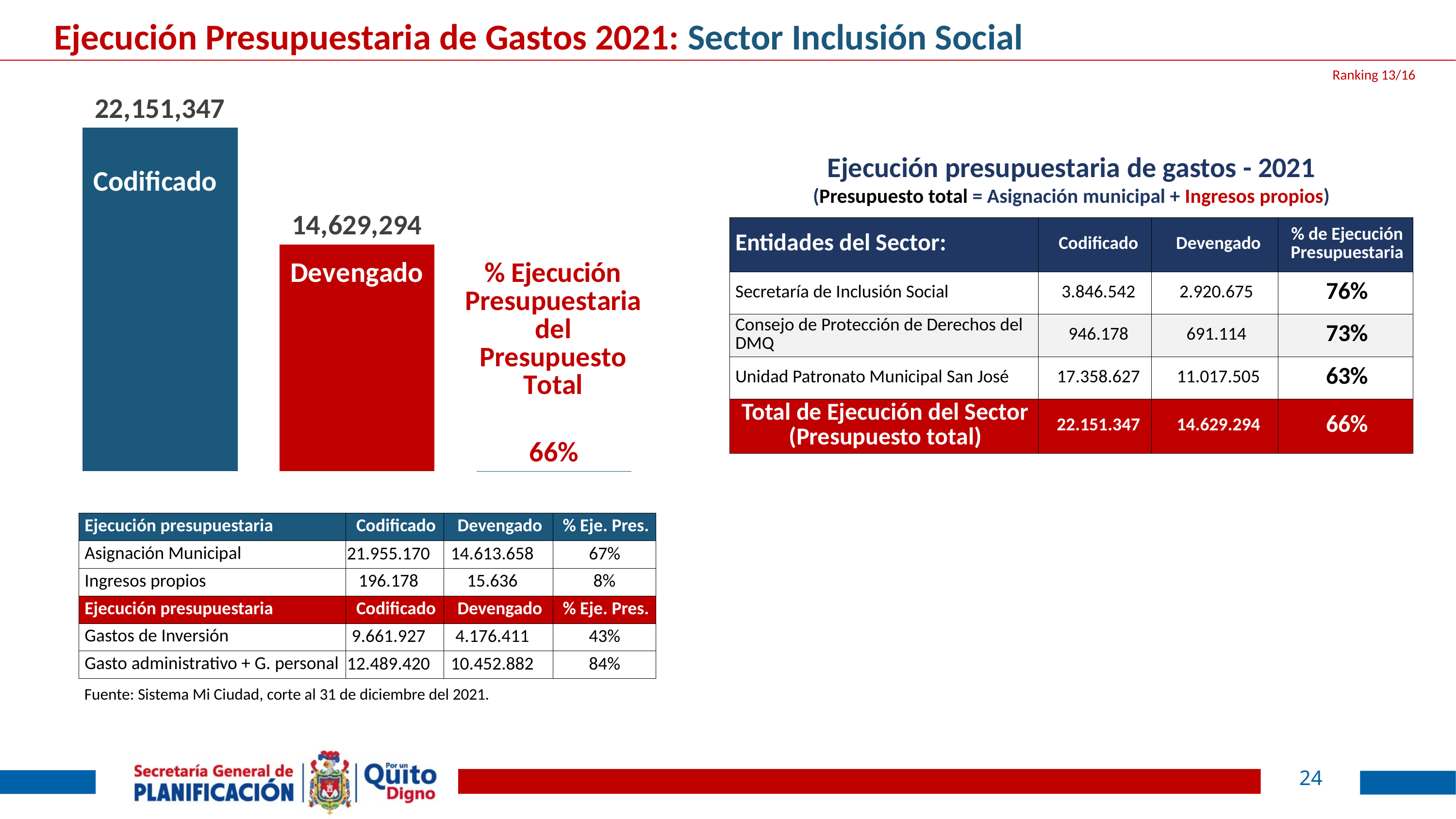
What is the difference between the Codificado and Devengado bars? 7,522,053 Which bar is the tallest in the chart? Codificado Which bar is the shortest in the chart? Devengado What is the value of the Codificado bar? 22,151,347 How many bars are shown in the chart? 2 Which is larger, Codificado or Devengado? Codificado What type of chart is shown on the slide? Bar chart What is the value of the Devengado bar? 14,629,294 What percentage is shown next to the chart as the % Ejecución Presupuestaria del Presupuesto Total? 66% What colour is the Devengado bar? Red